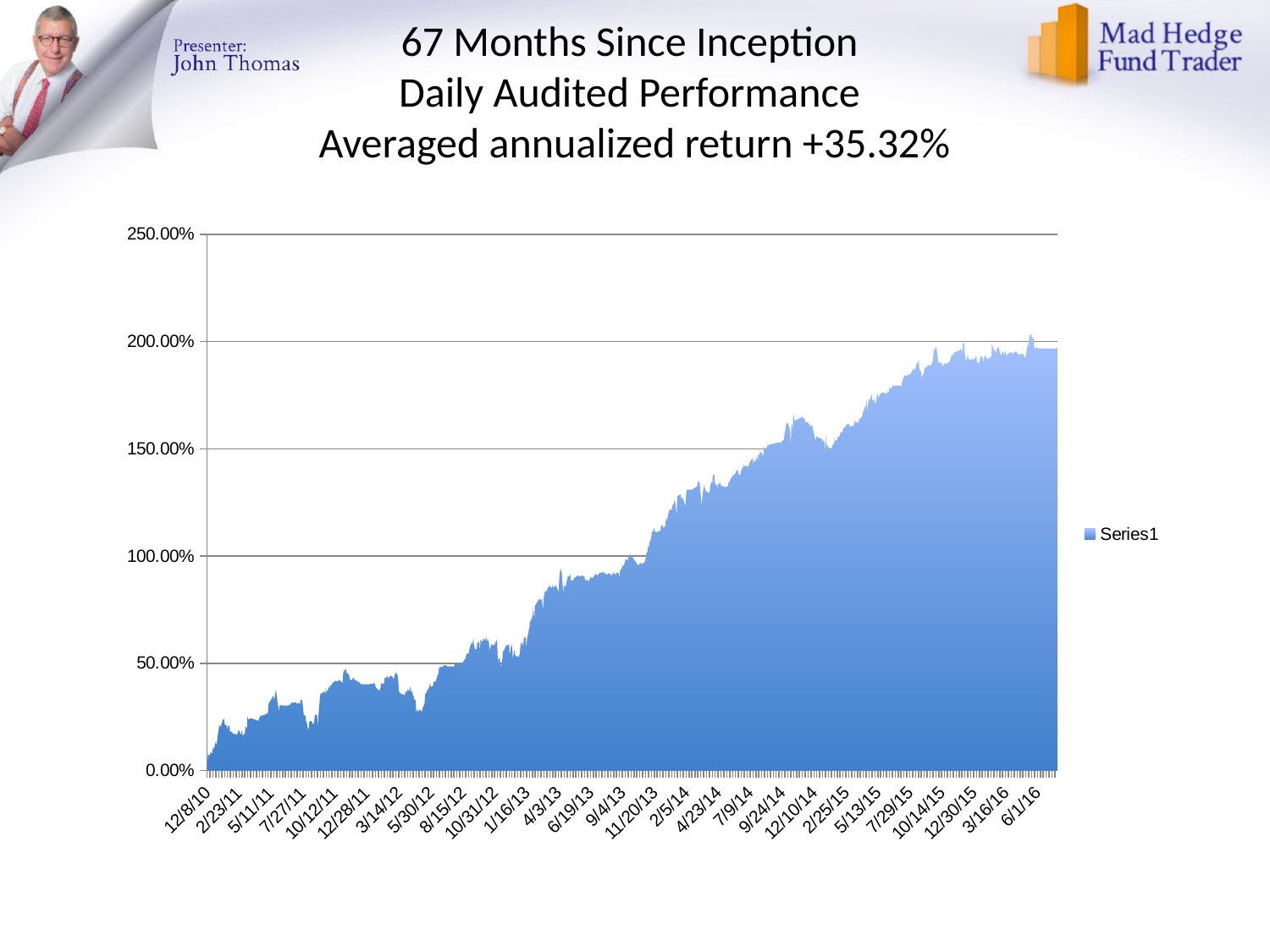
How many series does the legend list? 1 Is the value at 5/30/12 greater or less than 50.00%? less What is the name of the series shown in the legend? Series1 Which is larger, the value at 6/1/16 or the value at 12/8/10? 6/1/16 Is the value at 6/1/16 greater or less than 150.00%? greater Is the value at 4/3/13 greater or less than 100.00%? less What is the highest tick value shown on the vertical axis? 250.00% Do the values generally rise or fall from 12/8/10 to 6/1/16? Rise What kind of chart is shown on the slide? Area chart